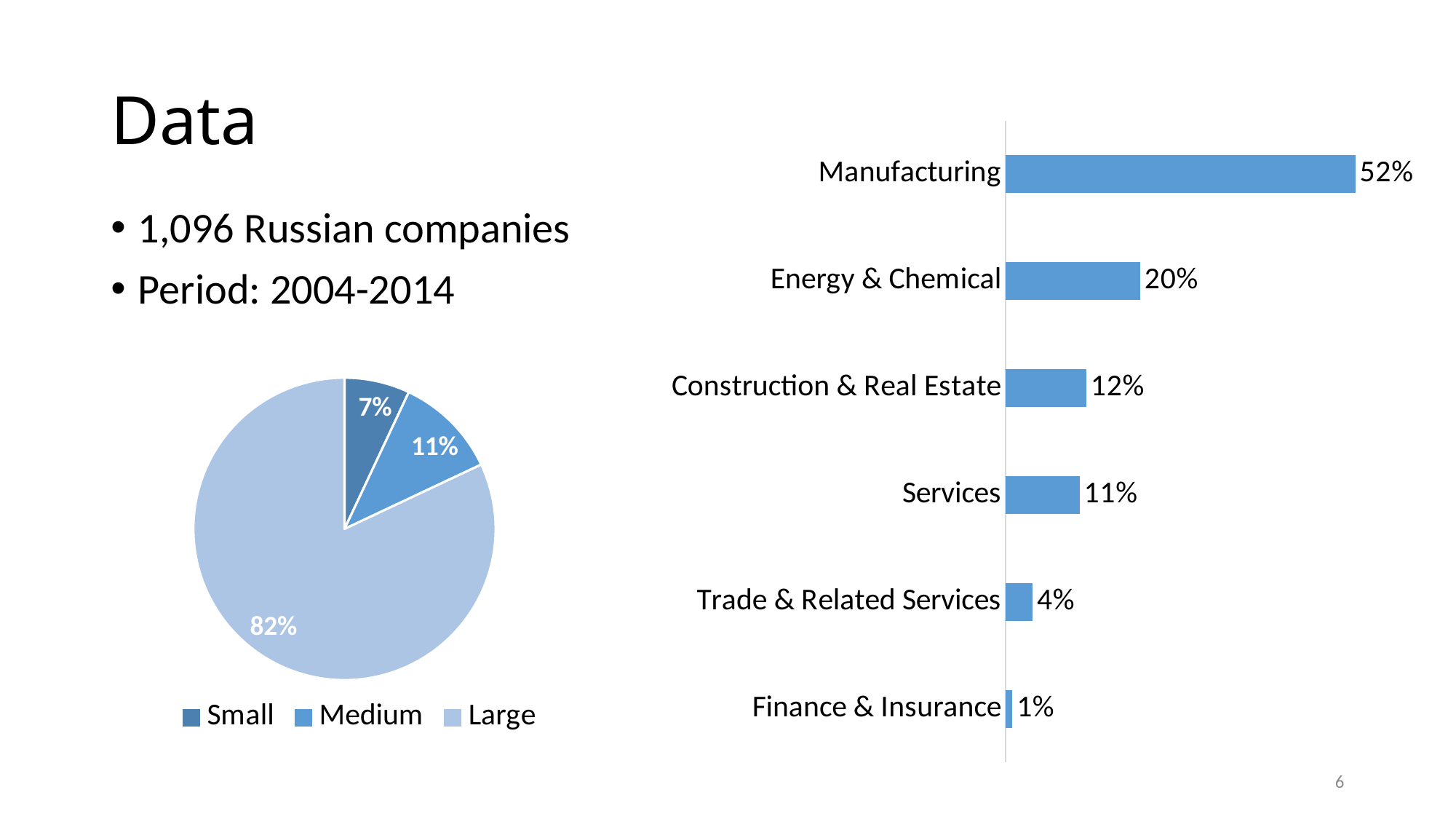
In the bar chart on the right, what is the value for Manufacturing? 52% In the bar chart on the right, which category has the lowest value? Finance & Insurance In the pie chart on the left, which category has the smallest slice? Small In the pie chart on the left, what share is labelled for Small? 7% In the pie chart on the left, how many categories does the legend list? 3 In the bar chart on the right, what is the difference between Manufacturing and Energy & Chemical? 32% In the bar chart on the right, what is the value for Trade & Related Services? 4% In the pie chart on the left, what share is labelled for Large? 82% In the pie chart on the left, which category has the largest slice? Large In the bar chart on the right, how many categories are shown? 6 What kind of chart is shown on the right side of the slide? Bar chart In the bar chart on the right, which is larger: Construction & Real Estate or Services? Construction & Real Estate